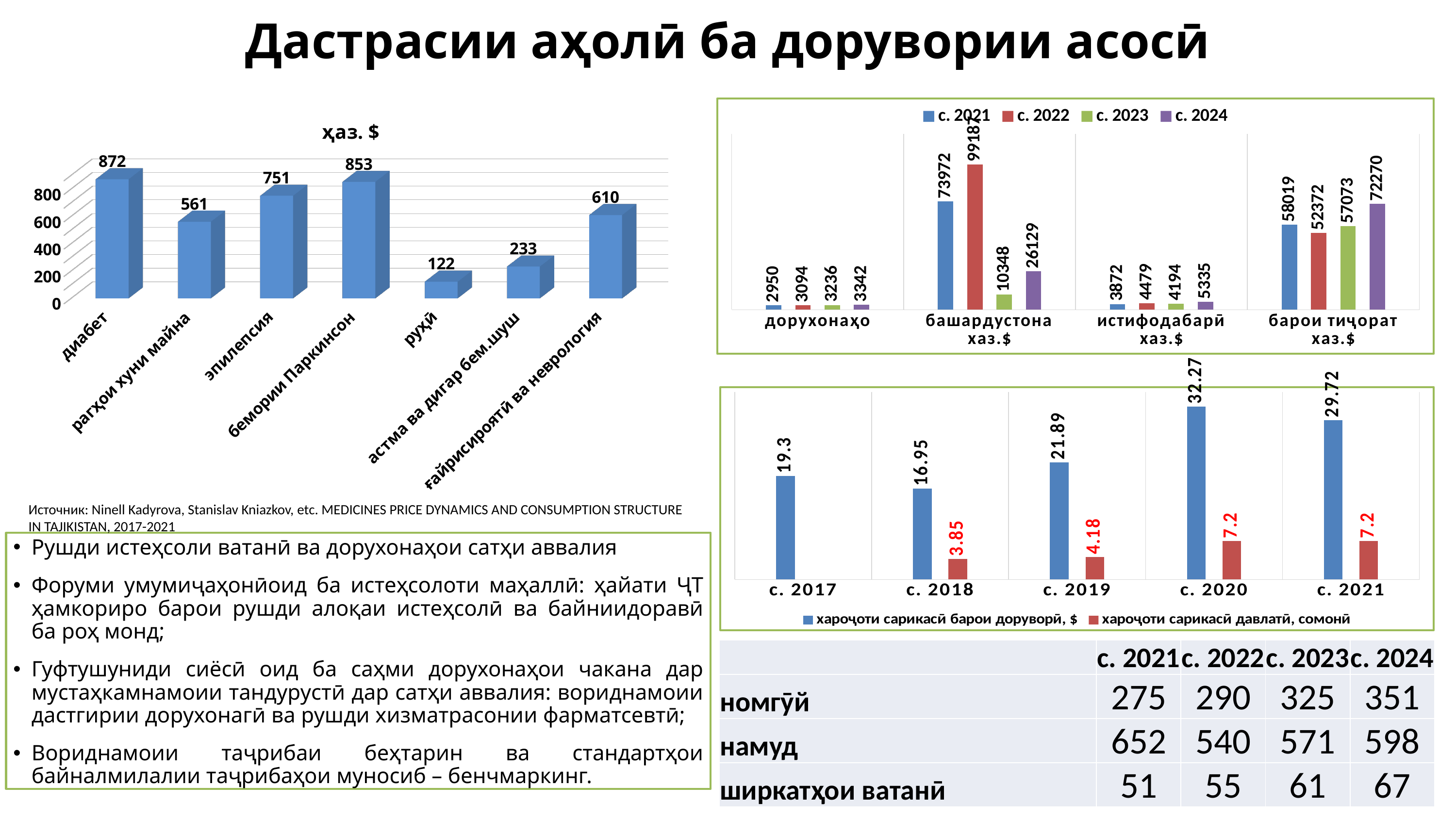
In the left chart titled 'ҳаз. $', how many categories are shown? 7 In the bottom-right chart, what is the value of хароҷоти сарикасӣ барои доруворӣ, $ in с. 2020? 32.27 In the top-right chart, which year has the highest value for барои тиҷорат ҳаз.$? с. 2024 In the left chart titled 'ҳаз. $', what is the difference between диабет and бемории Паркинсон? 19 In the top-right chart, which is larger for истифодабарӣ ҳаз.$: с. 2022 or с. 2023? с. 2022 In the top-right chart, what is the value for башардустона ҳаз.$ in с. 2022? 99187 In the bottom-right chart, what is the difference between хароҷоти сарикасӣ барои доруворӣ, $ in с. 2020 and с. 2021? 2.55 In the bottom-right chart, what is the value of хароҷоти сарикасӣ давлатӣ, сомонӣ in с. 2018? 3.85 In the left chart titled 'ҳаз. $', what kind of chart is it? bar chart In the left chart titled 'ҳаз. $', what is the value for диабет? 872 In the left chart titled 'ҳаз. $', which category has the lowest value? руҳӣ In the top-right chart, how many series does the legend list? 4